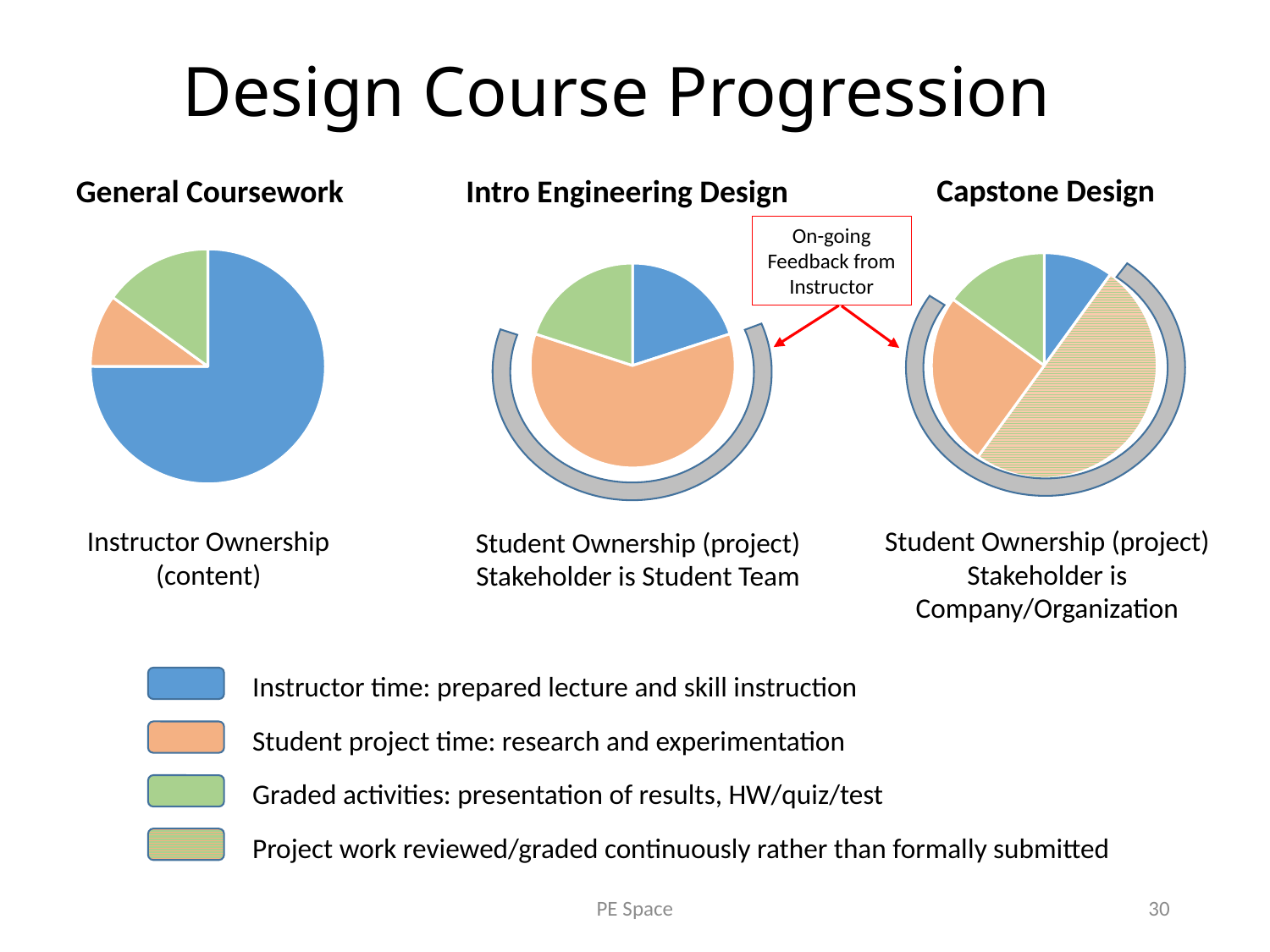
In the General Coursework pie chart, how many slices are there? 3 In the General Coursework pie chart, which category has the largest slice? Instructor time: prepared lecture and skill instruction In the General Coursework pie chart, which is larger: the instructor time slice or the graded activities slice? Instructor time In the Capstone Design pie chart, how many slices are there? 4 What kind of chart is used for General Coursework, Intro Engineering Design and Capstone Design? Pie chart In the Intro Engineering Design pie chart, which is larger: the instructor time slice or the student project time slice? Student project time How many pie charts are shown on the slide? 3 In the Capstone Design pie chart, which category has the largest slice? Project work reviewed/graded continuously rather than formally submitted How many entries does the legend at the bottom of the slide list? 4 In the Intro Engineering Design pie chart, which category has the largest slice? Student project time: research and experimentation What colour represents instructor time in the pie charts? Blue In the Capstone Design pie chart, which category has the smallest slice? Instructor time: prepared lecture and skill instruction